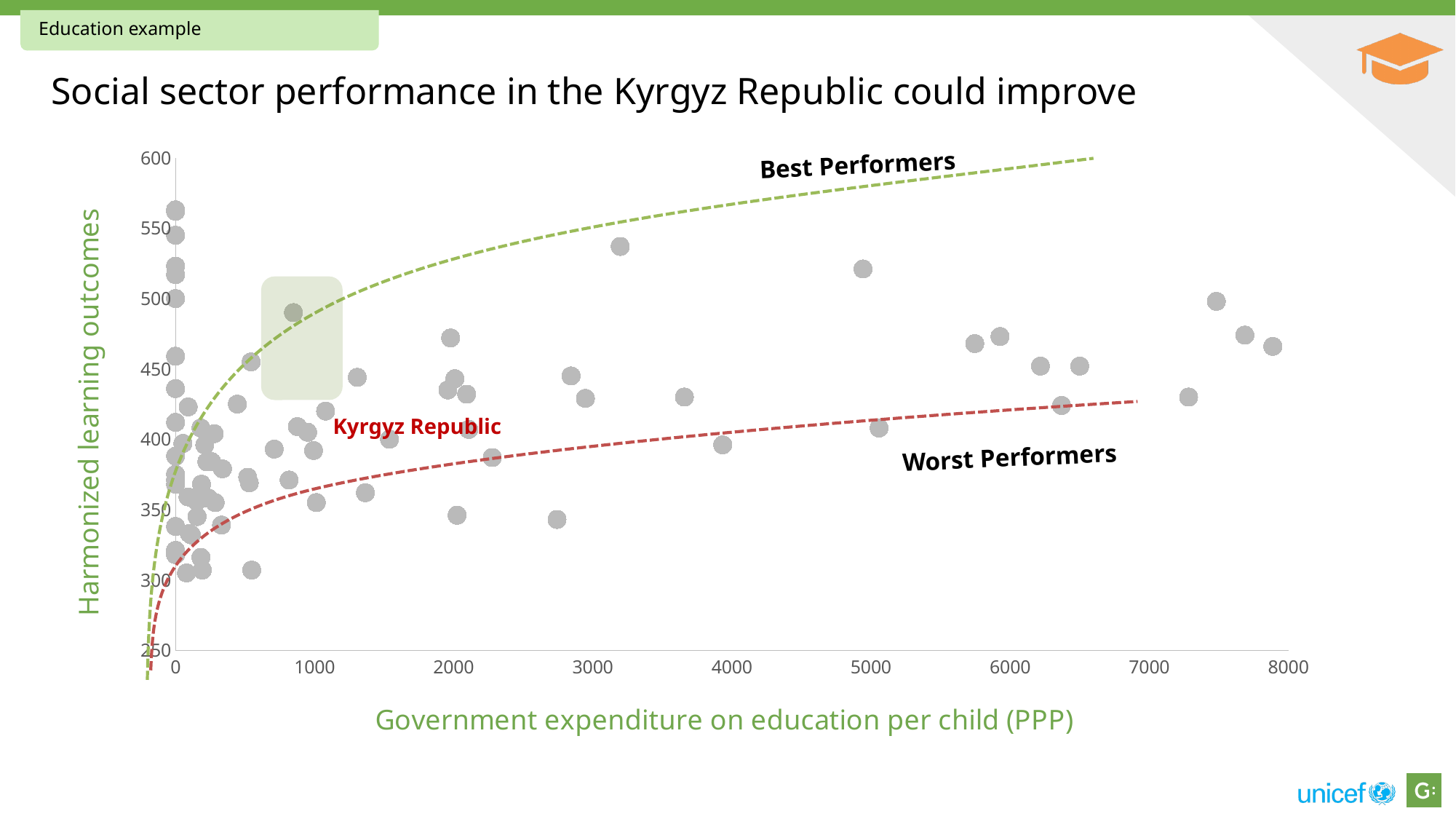
Is the government expenditure on education per child for the Kyrgyz Republic greater or less than 1000? less Does the 'Best Performers' dashed line rise or fall as government expenditure increases along the x axis? Rises Is the harmonized learning outcome for the Kyrgyz Republic greater or less than 500? less What kind of chart is shown on the slide? Scatter chart What is the title of the chart's x axis? Government expenditure on education per child (PPP) What is the highest value shown on the y axis of the chart? 600 Which dashed line lies higher on the chart, 'Best Performers' or 'Worst Performers'? Best Performers What is the title of the chart's y axis? Harmonized learning outcomes Is the government expenditure on education per child for the Kyrgyz Republic greater or less than 500? greater Does the 'Worst Performers' dashed line rise or fall as government expenditure increases along the x axis? Rises